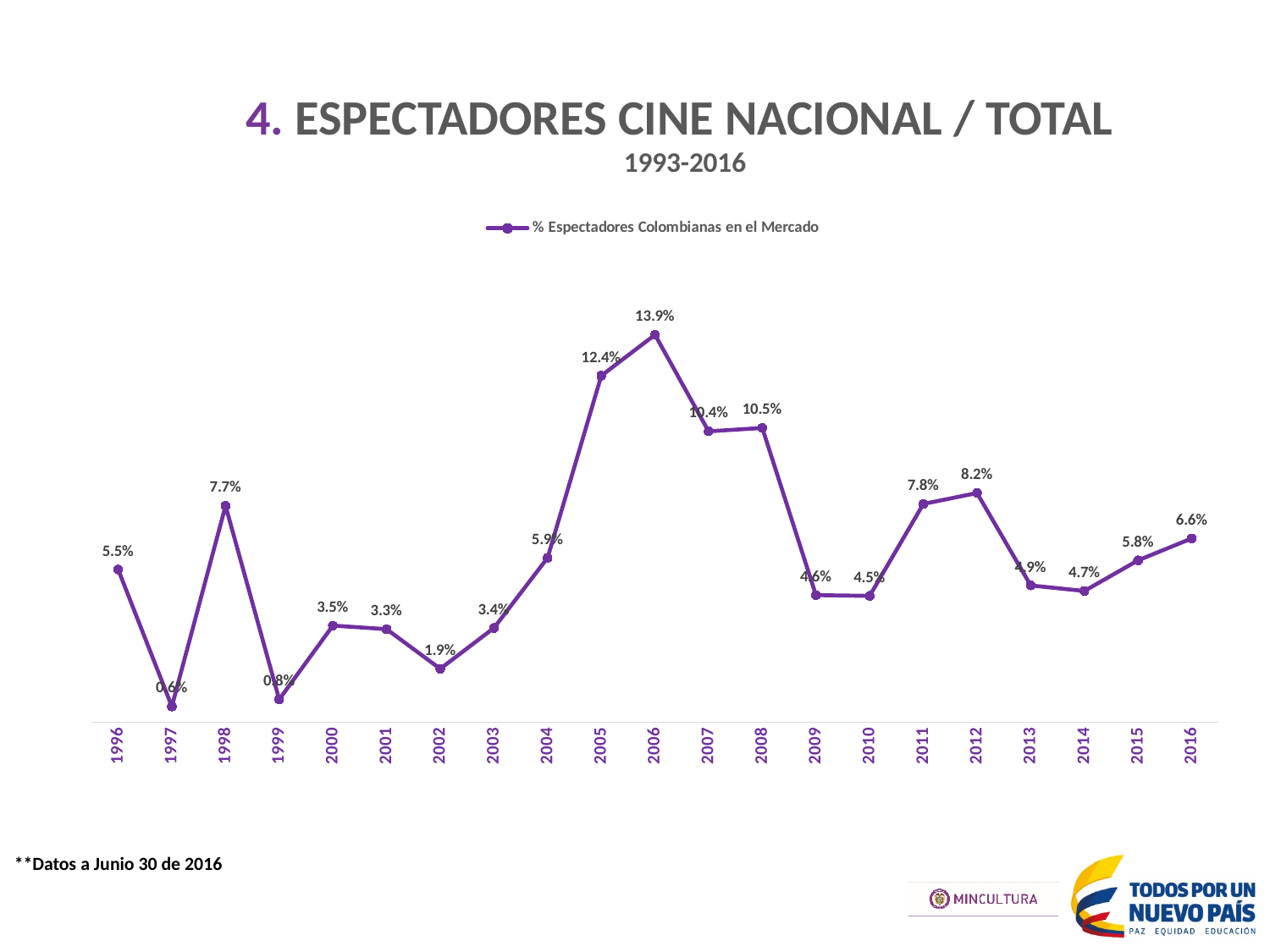
Which is larger, the value for 2011 or the value for 2015? 2011 How many years are plotted on the x axis? 21 What is the value for 2016? 6.6% Which year has the lowest value? 1997 What kind of chart is shown on the slide? line chart What is the value for 1998? 7.7% What is the name of the series shown in the legend? % Espectadores Colombianas en el Mercado What is the value for 2006? 13.9% What is the difference between the values for 2006 and 2005? 1.5% What is the value for 2012? 8.2% Which year has the highest value? 2006 How many series does the legend list? 1